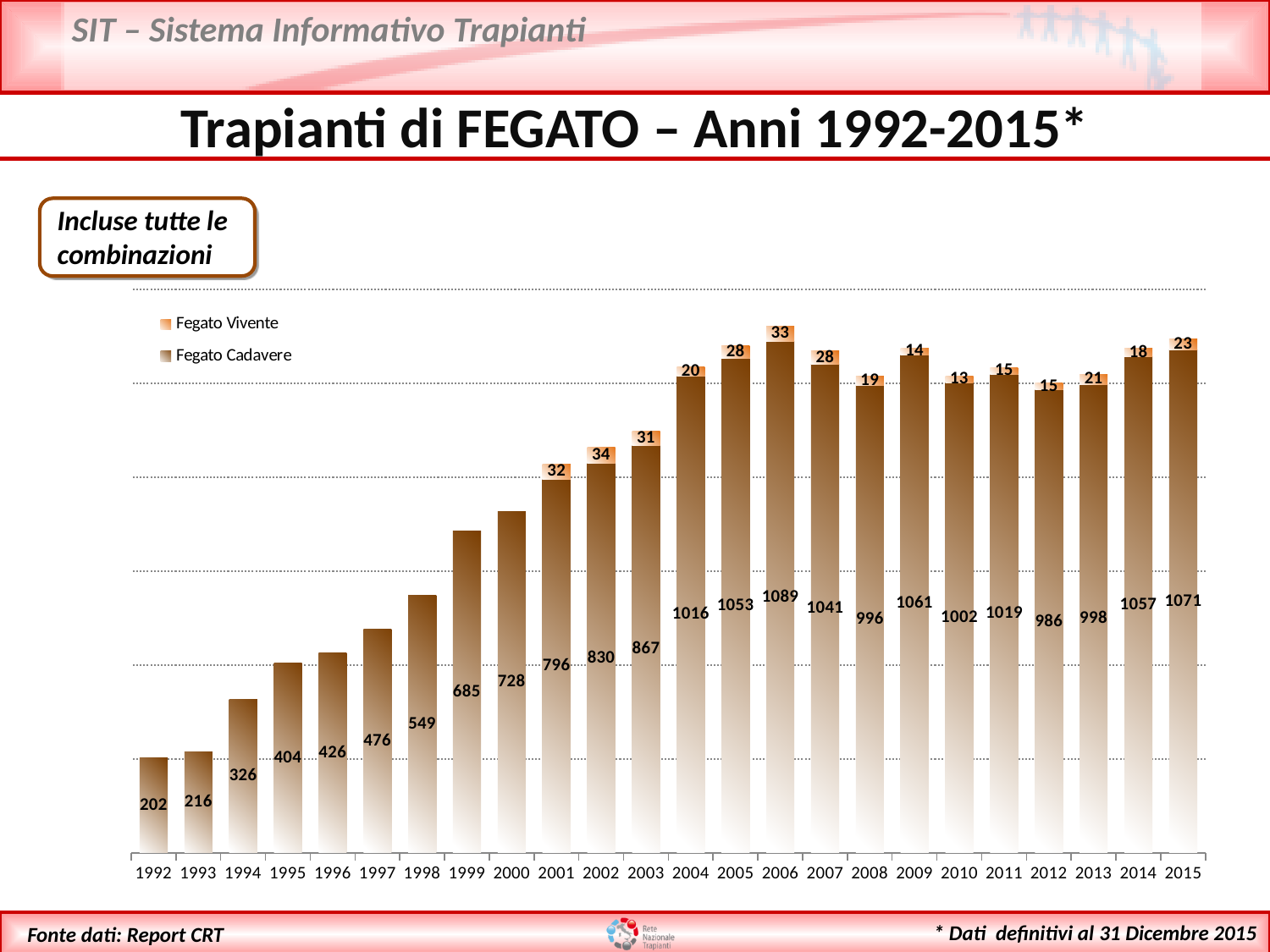
What kind of chart is shown on the slide? Stacked bar chart Which is larger, the Fegato Cadavere value for 2009 or for 2011? 2009 Which year has the lowest Fegato Cadavere value? 1992 How many years are shown on the x axis? 24 What is the Fegato Cadavere value for 1992? 202 How many series does the legend list? 2 Which year has the highest Fegato Vivente value? 2002 What is the Fegato Vivente value for 2015? 23 Which year has the highest Fegato Cadavere value? 2006 What is the total of the stacked bar for 2006? 1122 What is the difference between the Fegato Cadavere values for 2015 and 2014? 14 What is the Fegato Cadavere value for 2006? 1089